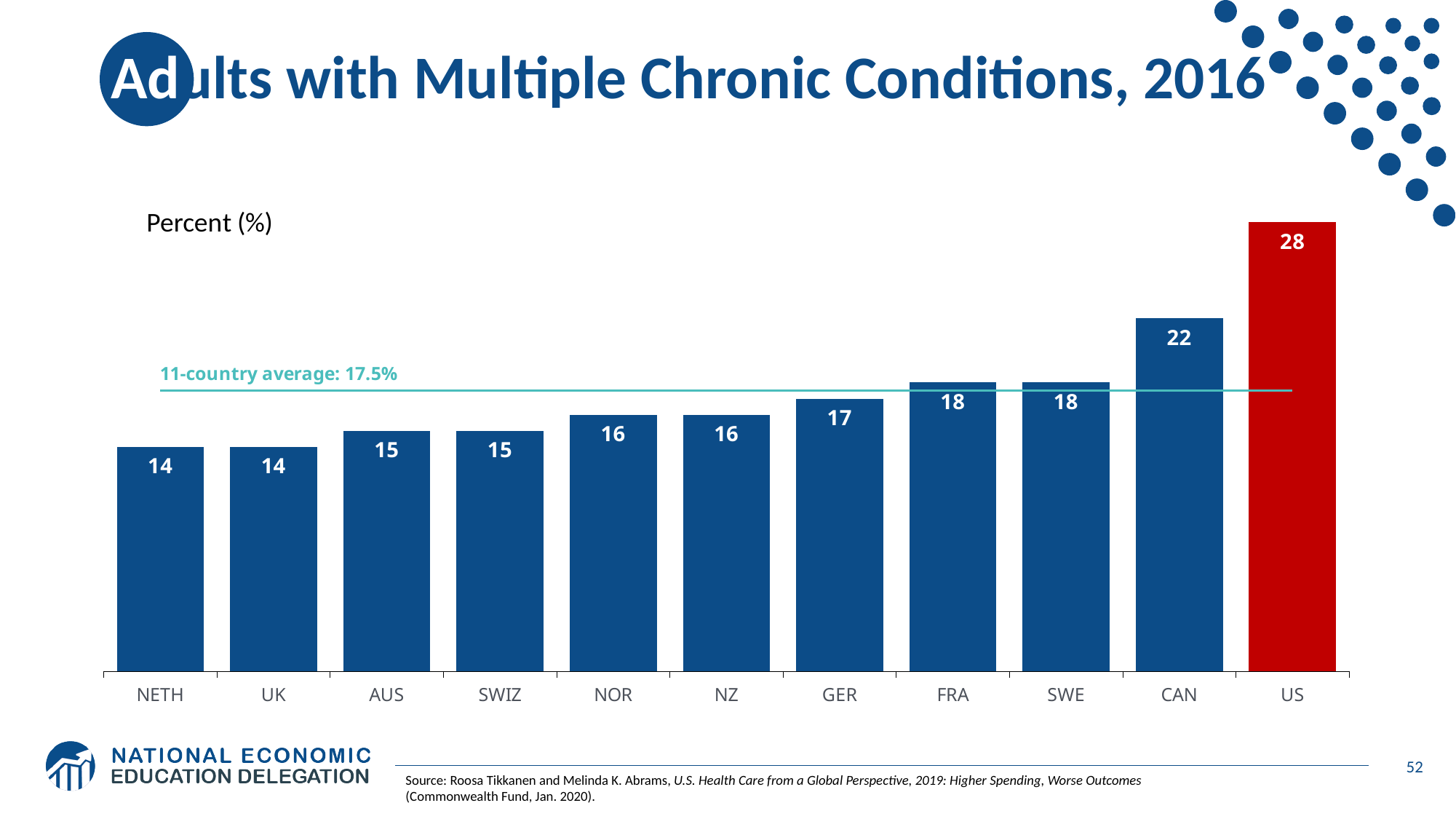
What is the difference between the values for FRA and NETH? 4 Which country has the highest value? US What is the value for GER? 17 Do the values generally rise or fall from left to right along the x axis? Rise Which has a larger value, NOR or CAN? CAN How many countries are shown on the chart? 11 What is the difference between the values for the US and CAN? 6 What kind of chart is shown on the slide? Bar chart What is the 11-country average shown on the chart? 17.5% Which has a larger value, AUS or GER? GER What is the value for CAN? 22 What is the value for the US? 28